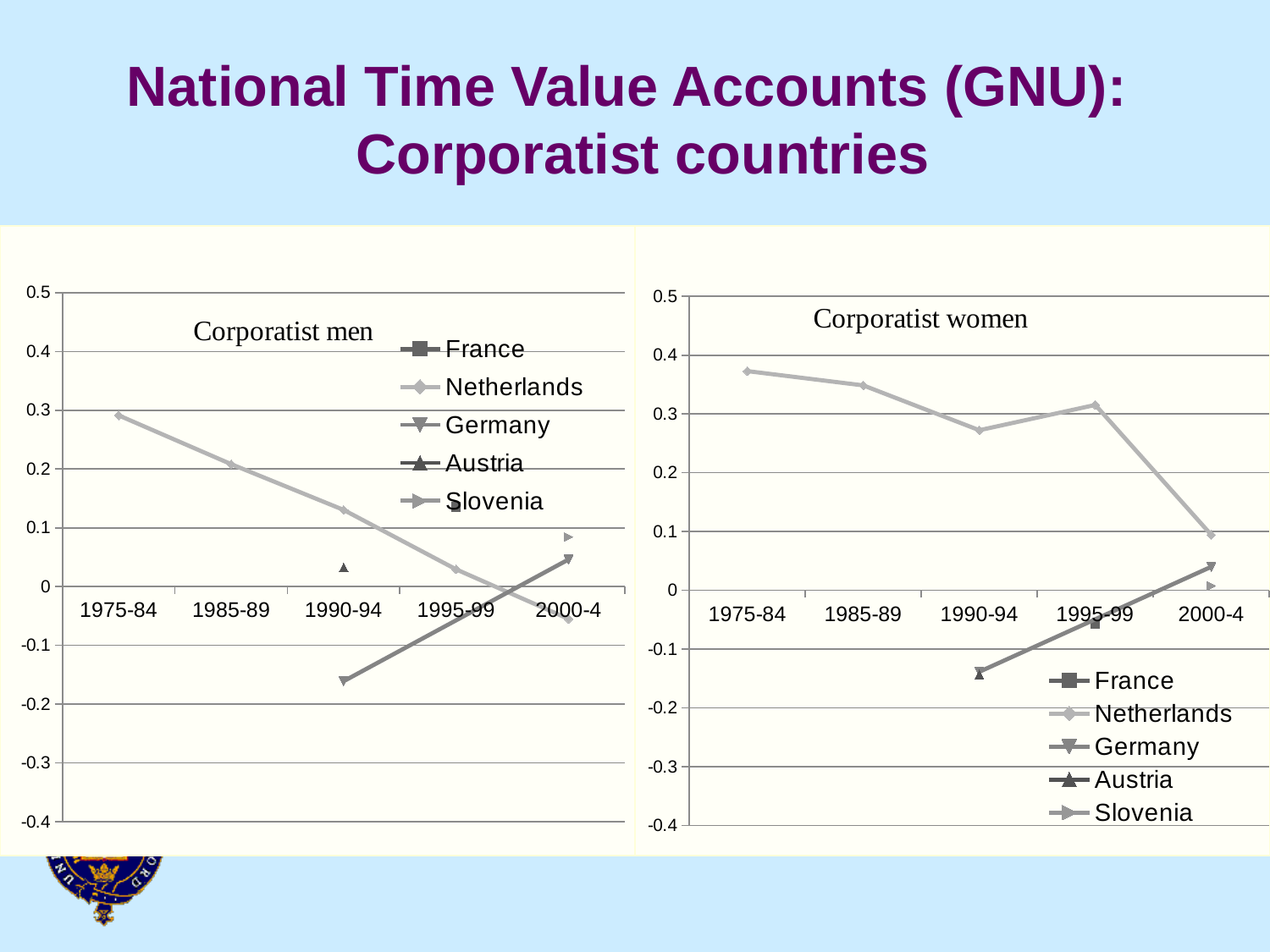
How many time periods are shown on the x axis of the 'Corporatist men' chart? 5 In the 'Corporatist women' chart, is the Netherlands value for 1975-84 greater or less than 0.3? greater In the 'Corporatist men' chart, is the Netherlands value for 2000-4 greater or less than 0? less What kind of chart is the 'Corporatist men' chart? line chart In the 'Corporatist women' chart, does the Netherlands line rise or fall overall from 1975-84 to 2000-4? fall Which series is listed first in the legend of the 'Corporatist men' chart? France How many series does the legend of the 'Corporatist women' chart list? 5 In the 'Corporatist men' chart, is the Netherlands value for 1975-84 greater or less than 0.2? greater In the 'Corporatist women' chart, which period has the higher Netherlands value, 1975-84 or 2000-4? 1975-84 In the 'Corporatist men' chart, which period has the highest Netherlands value? 1975-84 In the 'Corporatist men' chart, does the Netherlands line rise or fall from 1975-84 to 2000-4? fall